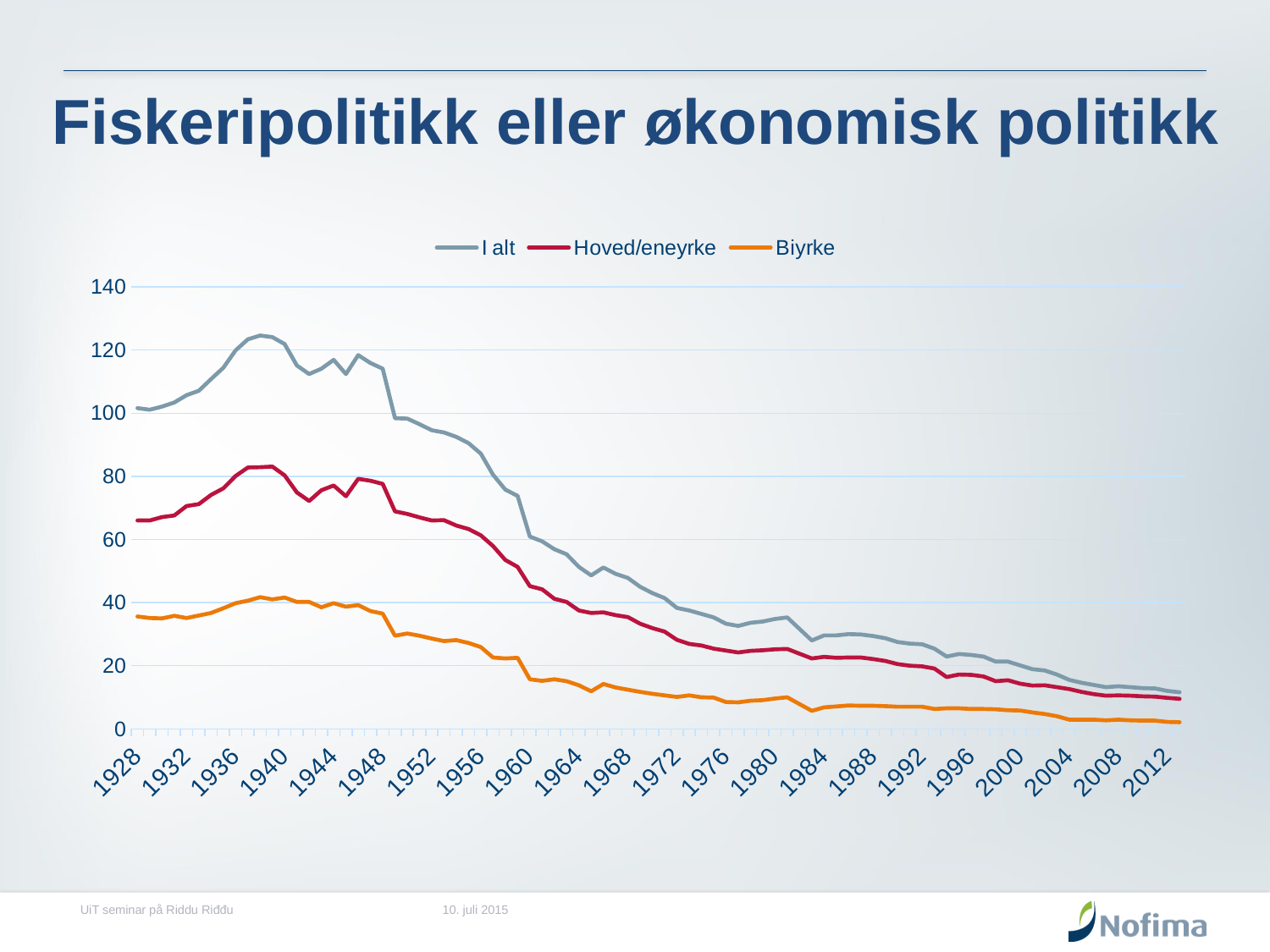
Is the value for Hoved/eneyrke in 1948 greater or less than 60? greater Which series has the highest values across the whole period? I alt In 1940, which is larger: Hoved/eneyrke or Biyrke? Hoved/eneyrke Is the value for I alt in 1928 greater or less than 80? greater Which series has the lowest values across the whole period? Biyrke What is the title of the slide containing the chart? Fiskeripolitikk eller økonomisk politikk What are the three series named in the legend? I alt, Hoved/eneyrke, Biyrke Is the value for Biyrke in 2012 greater or less than 20? less What kind of chart is shown on the slide? line chart Does the I alt series rise or fall between 1928 and 1940? rise Does the I alt series rise or fall between 1960 and 2012? fall How many series does the legend list? 3